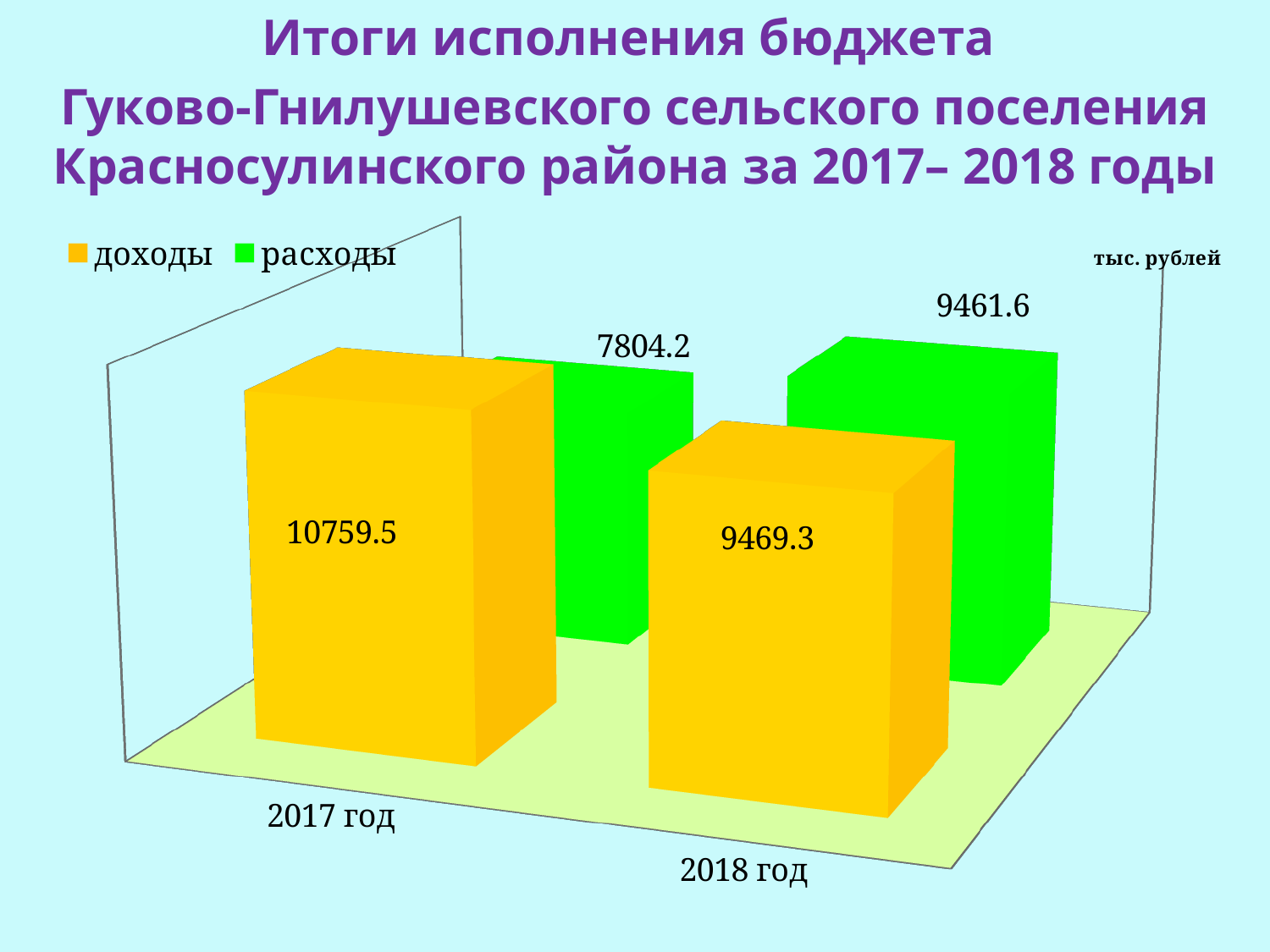
By how much did доходы decrease from 2017 год to 2018 год? 1290.2 How many series does the legend list? 2 Which year has the lower value of расходы? 2017 год Which year has the higher value of доходы? 2017 год Do the values of расходы rise or fall from 2017 год to 2018 год? rise What is the difference between доходы and расходы in 2017 год? 2955.3 What is the value of доходы for 2018 год? 9469.3 What is the value of расходы for 2018 год? 9461.6 Which is larger in 2017 год, доходы or расходы? доходы What is the value of расходы for 2017 год? 7804.2 What is the value of доходы for 2017 год? 10759.5 What kind of chart is shown on the slide? bar chart